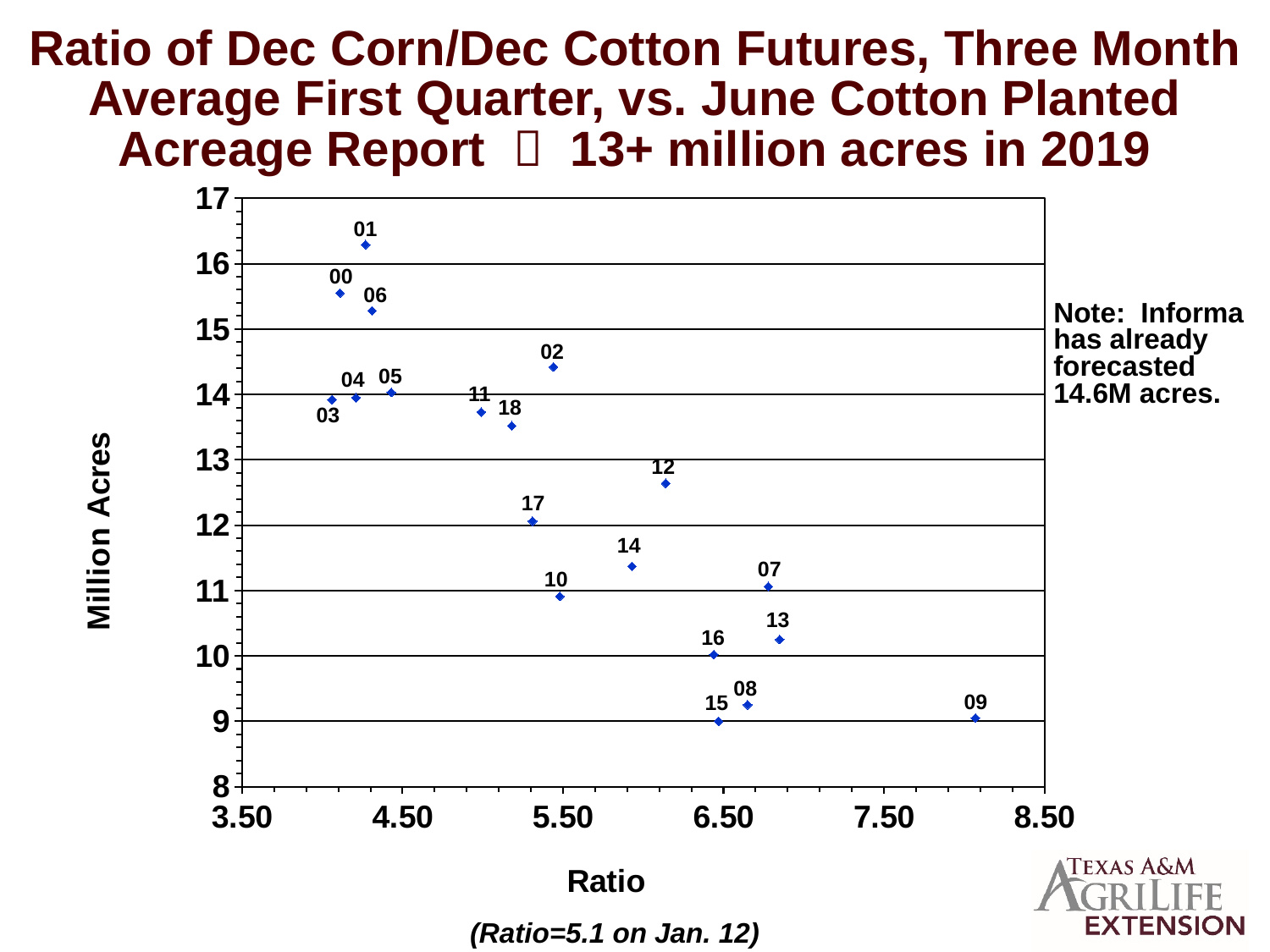
Is the million acres value for the point labeled 02 greater or less than 14? greater Which year's point has the highest value in million acres? 01 How many data points are plotted on the chart? 19 Is the million acres value for the point labeled 09 greater or less than 10? less What kind of chart is shown on the slide? scatter chart What is the label of the y axis? Million Acres Is the million acres value for the point labeled 01 greater or less than 16? greater Which year's point has the lowest value in million acres? 15 As the ratio increases along the x axis, do the million acres values generally rise or fall? fall Which point is higher in million acres, 02 or 12? 02 Which year's point has the highest ratio on the x axis? 09